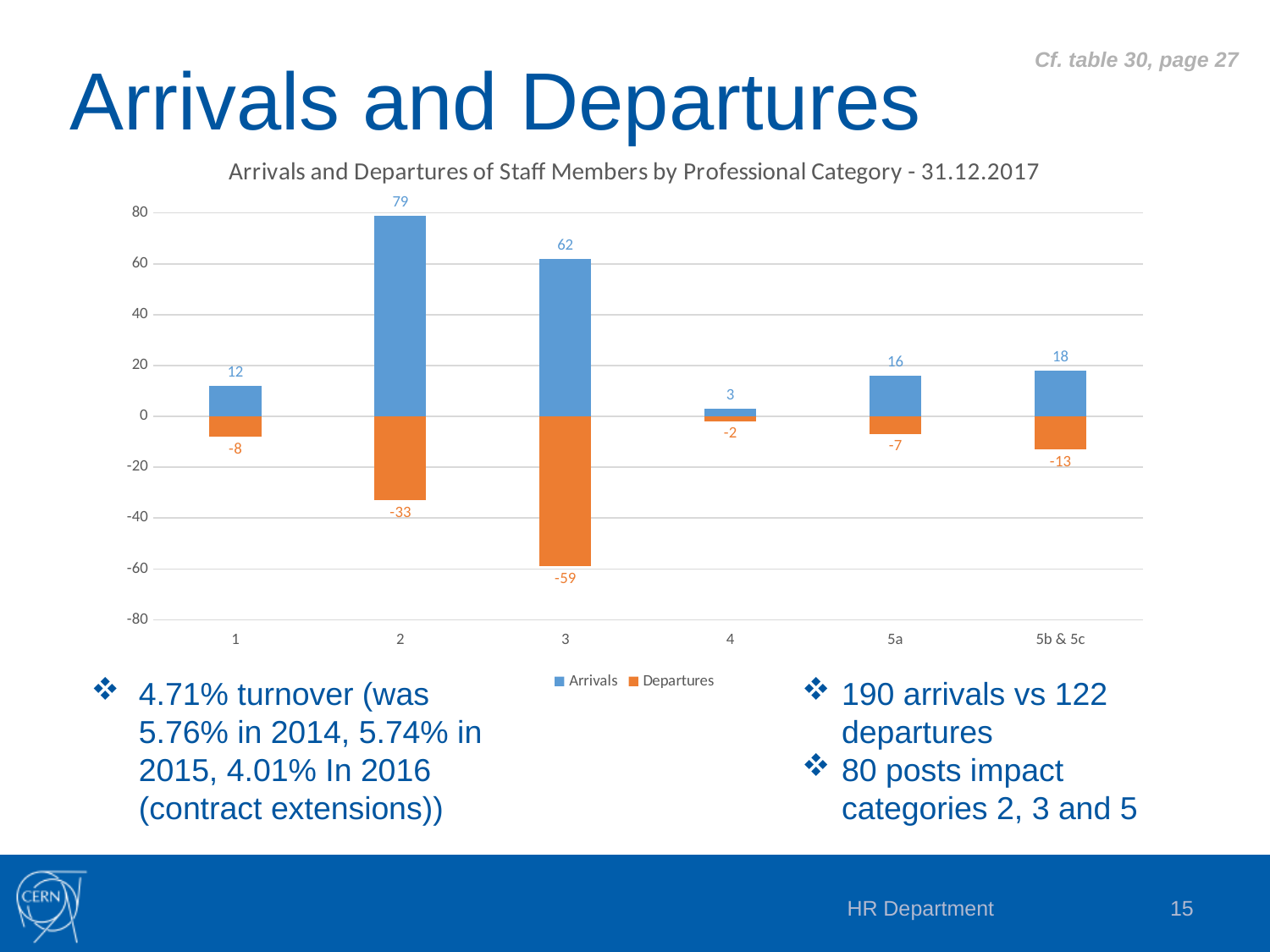
What is the Departures value for category 1? -8 What is the number of Arrivals for category 2? 79 What is the difference between Arrivals for category 2 and category 3? 17 Which category has the lowest number of Arrivals? 4 Which category has the highest number of Arrivals? 2 What is the Departures value for category 3? -59 How many professional categories are shown on the x axis? 6 Which category has more Arrivals, 5a or 5b & 5c? 5b & 5c How many series does the legend list? 2 What kind of chart is shown on the slide? Bar chart What is the title of the chart? Arrivals and Departures of Staff Members by Professional Category - 31.12.2017 What is the Arrivals value for category 5b & 5c? 18